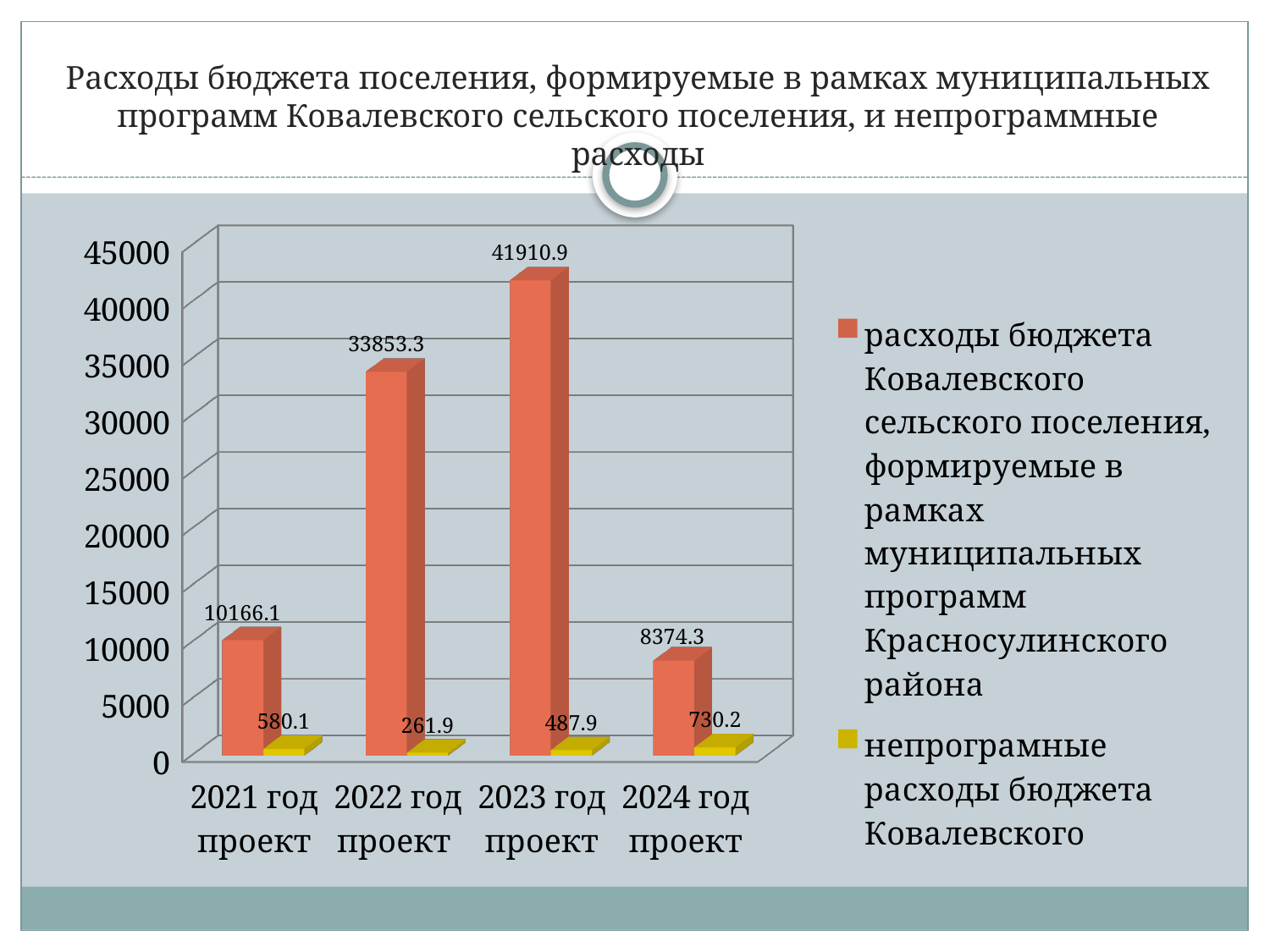
What colour are the bars for the non-program expenses (непрограмные расходы) series? Yellow Which year has the highest program expenses? 2023 год проект What is the value of the program expenses for 2021 год проект? 10166.1 Which is larger: program expenses in 2021 год проект or in 2024 год проект? 2021 год проект Which year has the lowest non-program expenses? 2022 год проект What is the value of the non-program expenses (непрограмные расходы) for 2024 год проект? 730.2 What kind of chart is shown on the slide? Bar chart How many year categories are shown on the x axis? 4 What is the difference between non-program expenses in 2024 год проект and 2022 год проект? 468.3 What is the difference between program expenses in 2023 год проект and 2022 год проект? 8057.6 What is the value of the program expenses (расходы бюджета ... формируемые в рамках муниципальных программ) for 2023 год проект? 41910.9 How many series does the legend list? 2